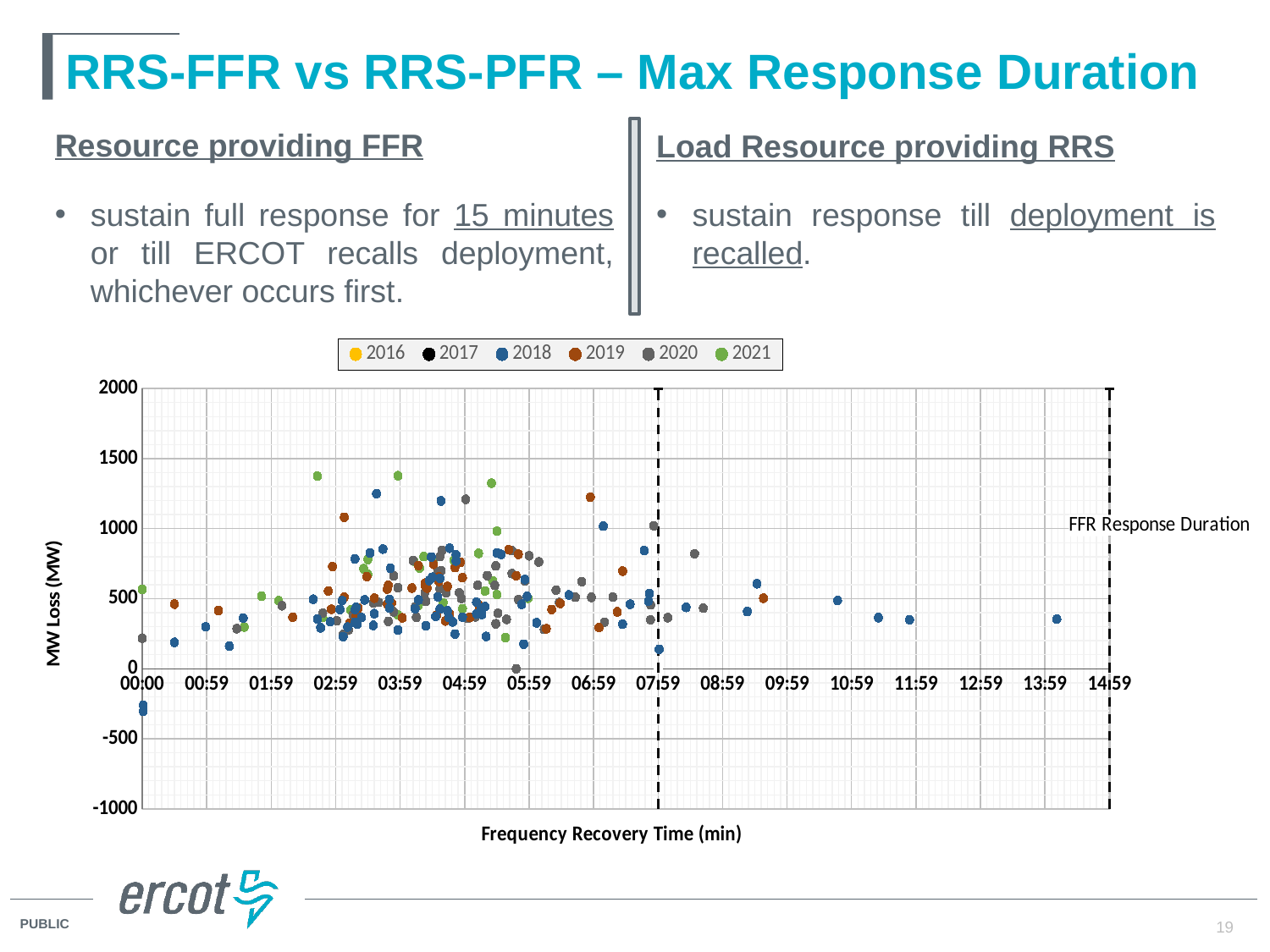
Is the MW Loss value of the plotted point near 10:59 greater or less than 1000? less What kind of chart is shown on the slide? Scatter chart How many series does the chart legend list? 6 Is the MW Loss value of the lowest plotted point (near 00:00) greater or less than 0? less What label is shown next to the dashed vertical line at the right of the chart? FFR Response Duration What are the series names listed in the chart legend? 2016, 2017, 2018, 2019, 2020, 2021 Is the MW Loss value of the highest plotted point greater or less than 1000? greater